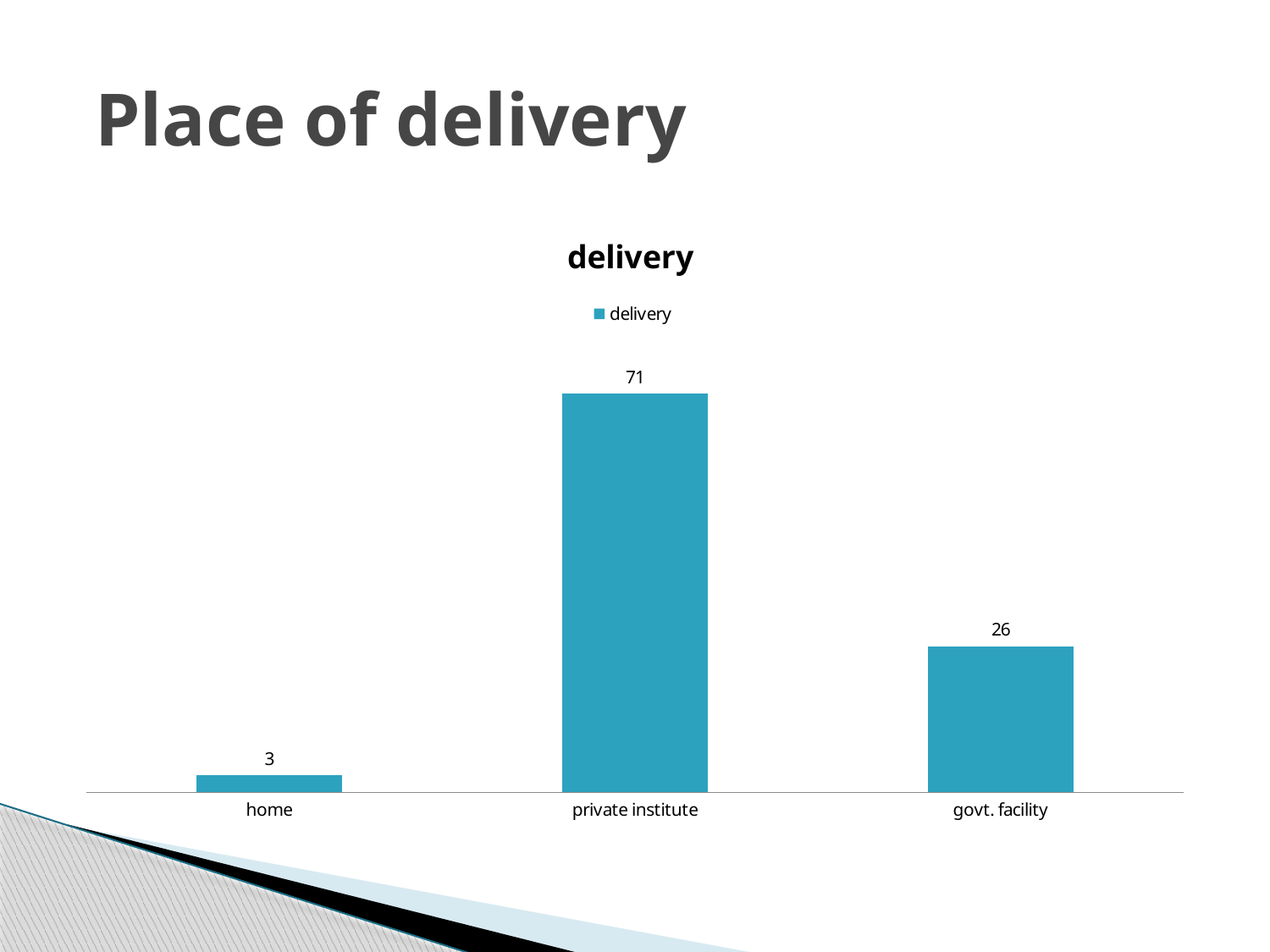
Which category has the highest value? private institute How many series does the legend list? 1 What is the value for govt. facility? 26 What is the difference between the values for govt. facility and home? 23 What kind of chart is shown on the slide? bar chart Which category has the lowest value? home How many categories are shown on the x axis? 3 What is the title of the chart? delivery What is the value for home? 3 Which is larger, the value for govt. facility or the value for home? govt. facility What is the difference between the values for private institute and govt. facility? 45 What is the value for private institute? 71